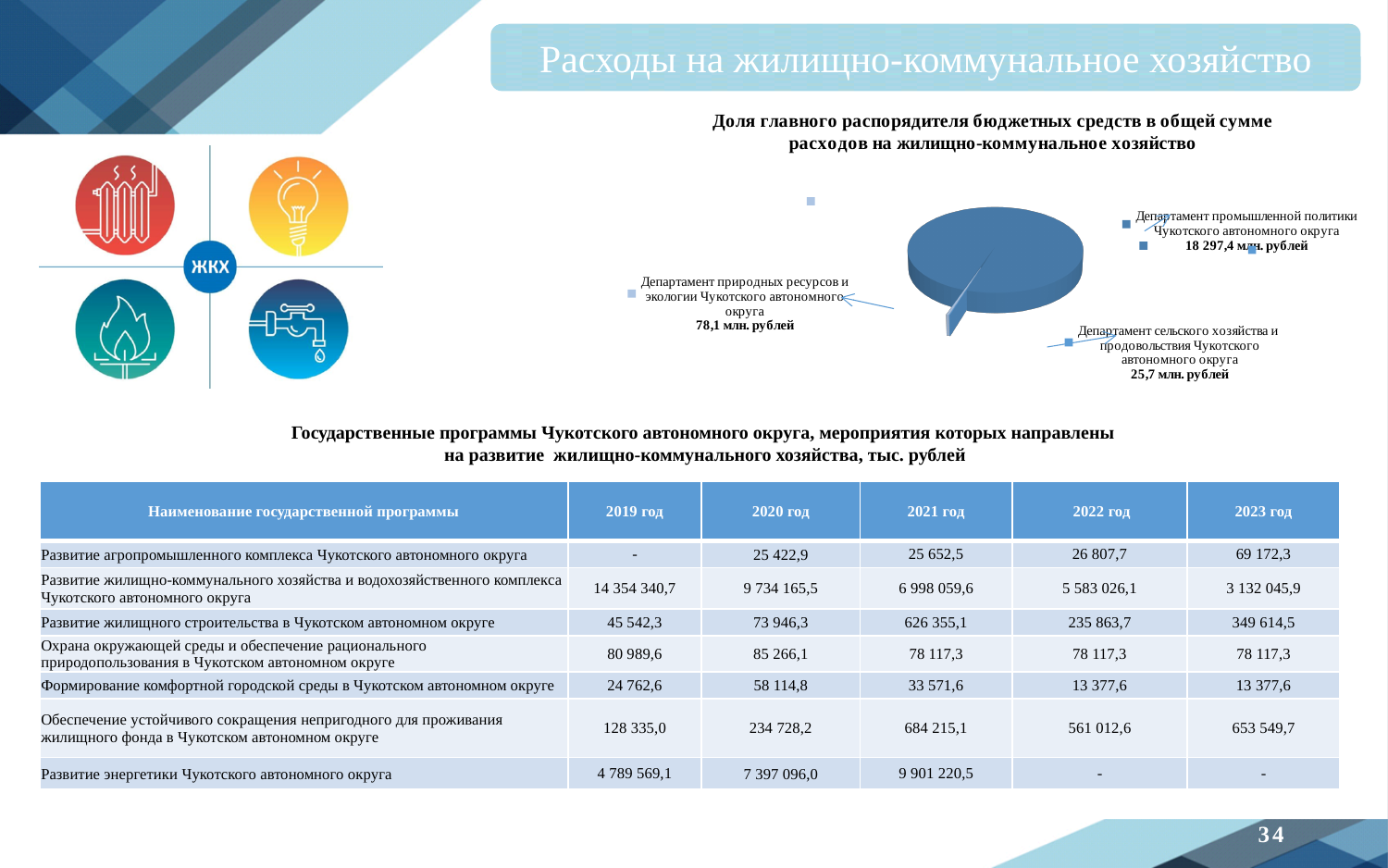
In the pie chart, what is the difference between the value for Департамент природных ресурсов и экологии (78,1 млн. рублей) and the value for Департамент сельского хозяйства и продовольствия (25,7 млн. рублей)? 52,4 млн. рублей In the pie chart, what value is shown for Департамент промышленной политики Чукотского автономного округа? 18 297,4 млн. рублей What is the title of the pie chart on the slide? Доля главного распорядителя бюджетных средств в общей сумме расходов на жилищно-коммунальное хозяйство How many departments (slices) are labelled in the pie chart? 3 What kind of chart is shown under the title 'Доля главного распорядителя бюджетных средств в общей сумме расходов на жилищно-коммунальное хозяйство'? Pie chart Which department has the largest share in the pie chart? Департамент промышленной политики Чукотского автономного округа In the pie chart, what value is shown for Департамент природных ресурсов и экологии Чукотского автономного округа? 78,1 млн. рублей In the pie chart, what value is shown for Департамент сельского хозяйства и продовольствия Чукотского автономного округа? 25,7 млн. рублей What is the total of the three values labelled in the pie chart? 18 401,2 млн. рублей In the pie chart, what is the difference between the value for Департамент промышленной политики (18 297,4 млн. рублей) and the value for Департамент природных ресурсов и экологии (78,1 млн. рублей)? 18 219,3 млн. рублей Which department has the smallest share in the pie chart? Департамент сельского хозяйства и продовольствия Чукотского автономного округа In the pie chart, which is larger: the value for Департамент природных ресурсов и экологии or the value for Департамент сельского хозяйства и продовольствия? Департамент природных ресурсов и экологии